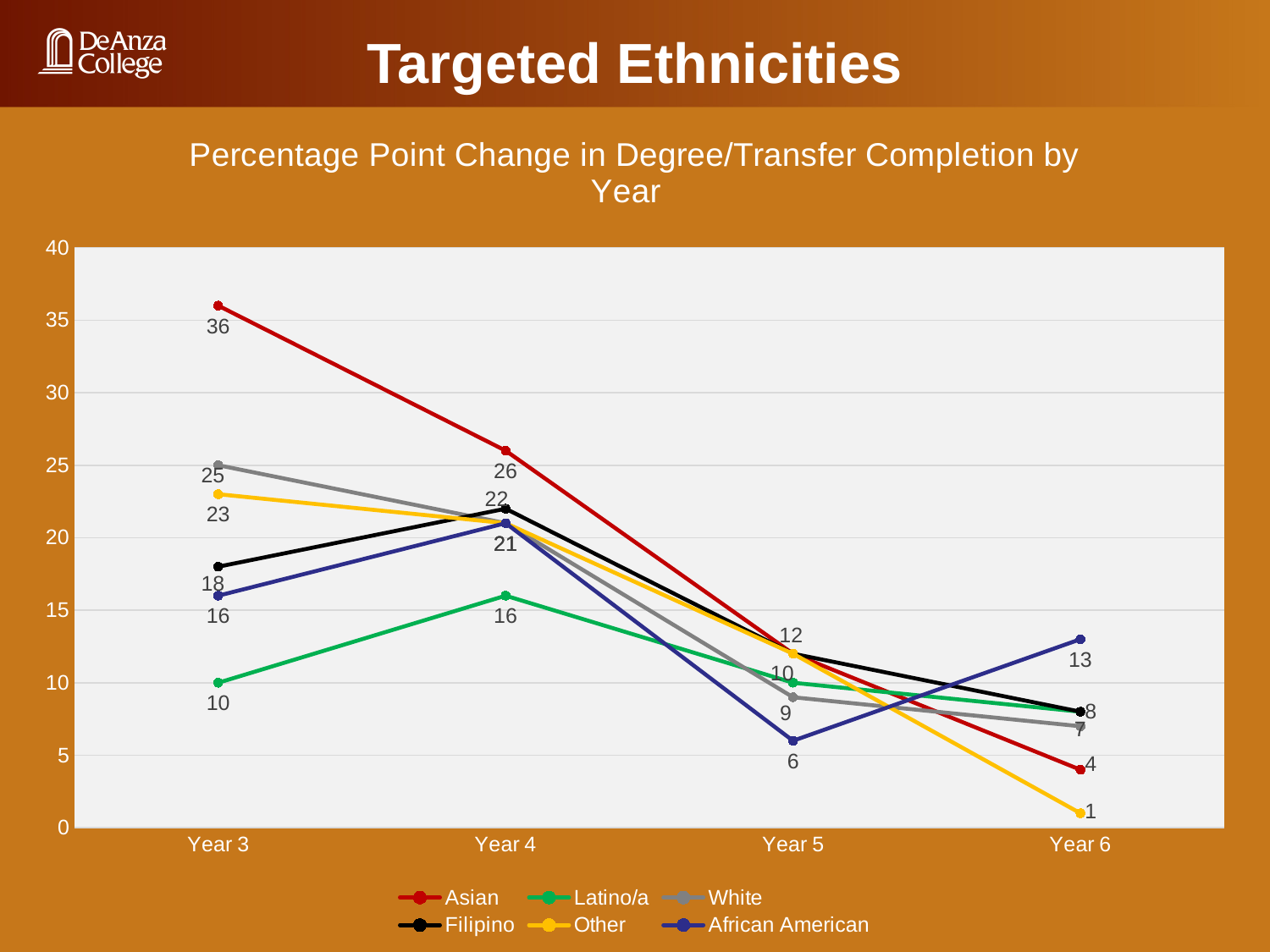
How many years are shown on the x axis? 4 Which series has the highest value in Year 3? Asian Which series has the lowest value in Year 6? Other Does the Asian series rise or fall from Year 3 to Year 6? Fall What is the value for Asian in Year 3? 36 What is the value for Latino/a in Year 4? 16 What kind of chart is shown on the slide? Line chart What is the value for African American in Year 6? 13 How many series does the legend list? 6 By how much did the Asian value drop from Year 3 to Year 4? 10 In Year 3, which is larger: the value for White or the value for Other? White What is the value for Other in Year 6? 1